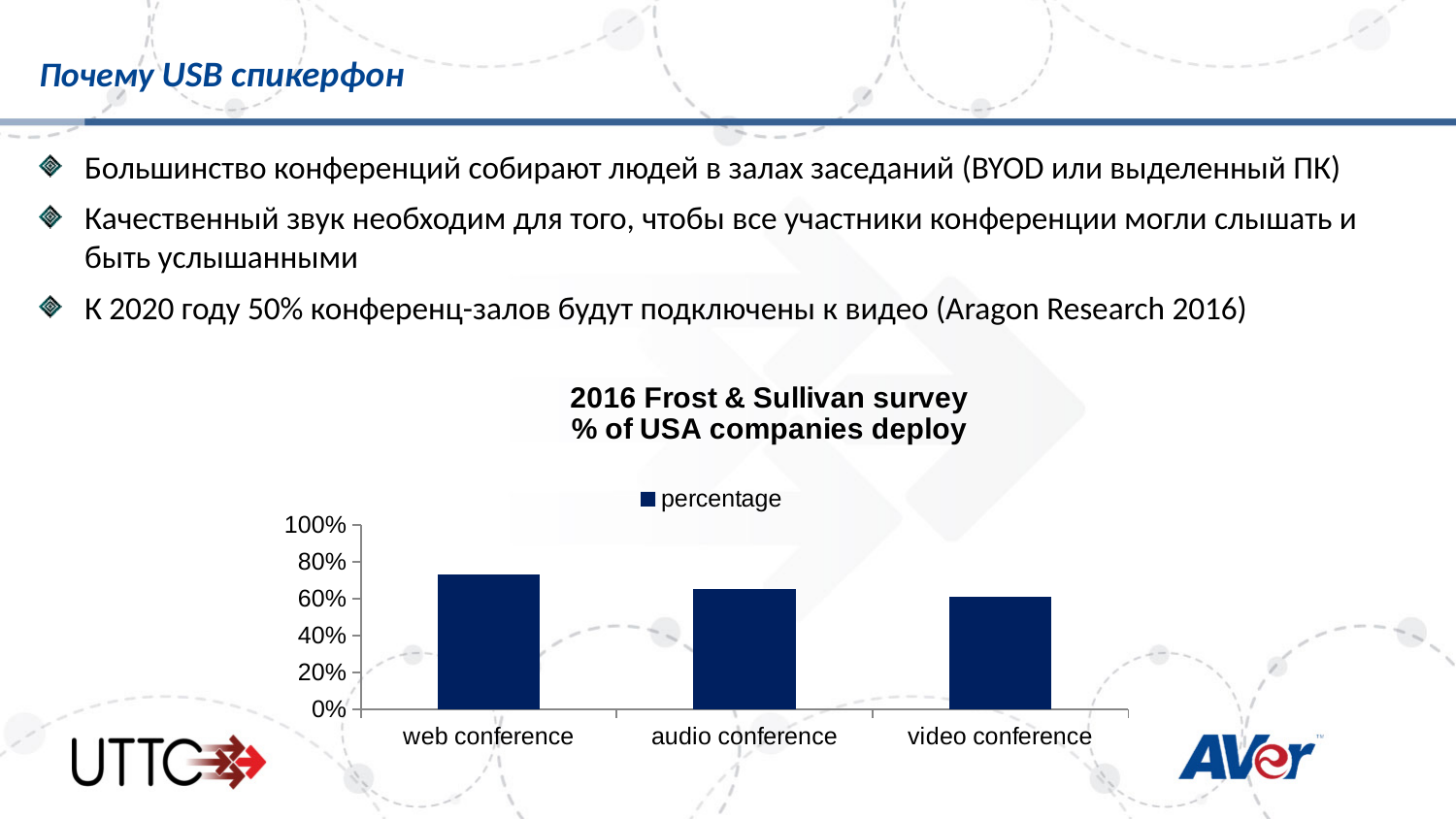
Is the value for web conference greater or less than 60%? greater Is the value for video conference greater or less than 80%? less How many series does the chart's legend list? 1 What kind of chart is shown on the slide? bar chart What is the name of the series shown in the chart's legend? percentage Which is larger, the value for web conference or the value for video conference? web conference How many categories are plotted on the x axis of the chart? 3 Is the value for audio conference greater or less than 40%? greater Which category has the lowest value in the chart? video conference What is the title of the chart? 2016 Frost & Sullivan survey % of USA companies deploy Which category has the highest value in the chart? web conference Do the values rise or fall moving from web conference to video conference along the x axis? fall